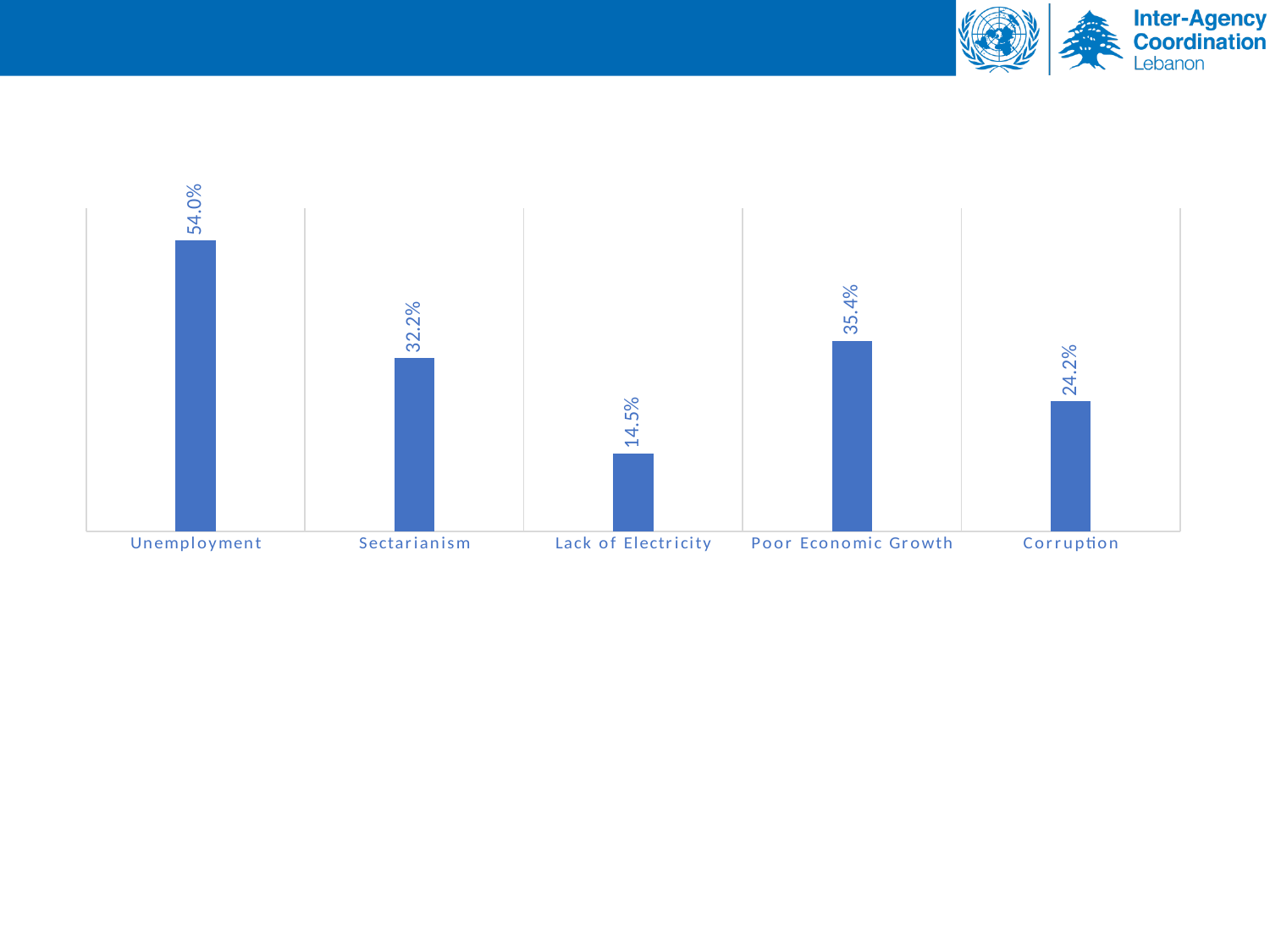
What is the value for Lack of Electricity? 14.5% What is the value for Poor Economic Growth? 35.4% Which category has the lowest value? Lack of Electricity What kind of chart is shown on the slide? Bar chart What is the value for Sectarianism? 32.2% What is the value for Unemployment? 54.0% What is the difference between the values for Poor Economic Growth and Corruption? 11.2% What is the difference between the values for Unemployment and Sectarianism? 21.8% How many categories are shown on the chart? 5 Which category has the highest value? Unemployment Which is larger, the value for Sectarianism or the value for Corruption? Sectarianism What is the value for Corruption? 24.2%